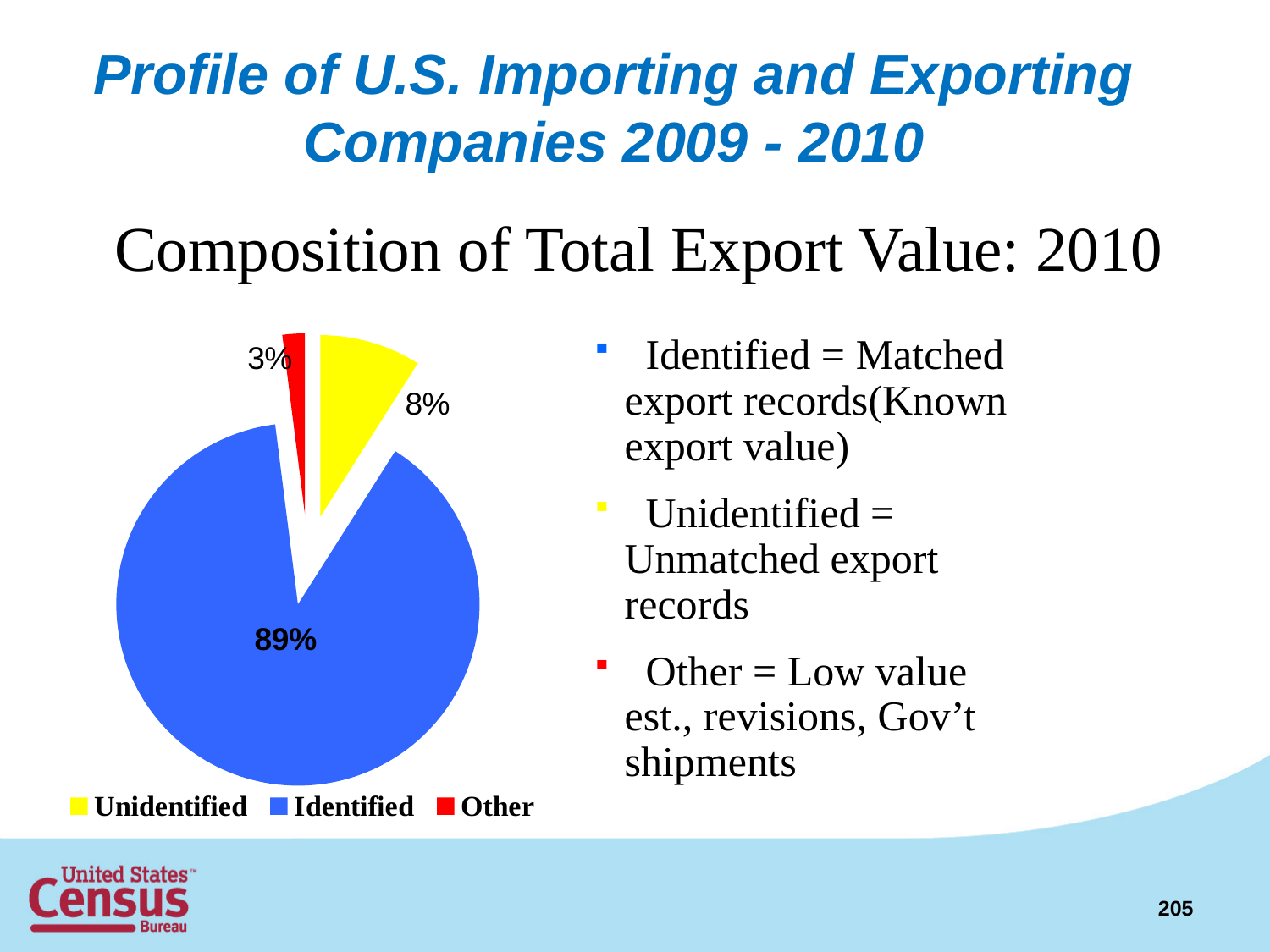
How many categories does the pie chart show? 3 Which category has the smallest slice of the pie? Other Which category has the largest slice of the pie? Identified What is the difference in percentage points between the Identified and Unidentified slices? 81 What share of total export value is Other? 3% Which is larger, the Unidentified slice or the Other slice? Unidentified What type of chart is shown on the slide? pie chart What share of total export value is Identified? 89% What colour is the Identified slice? blue What is the difference in percentage points between the Unidentified and Other slices? 5 What is the title of the chart? Composition of Total Export Value: 2010 What share of total export value is Unidentified? 8%